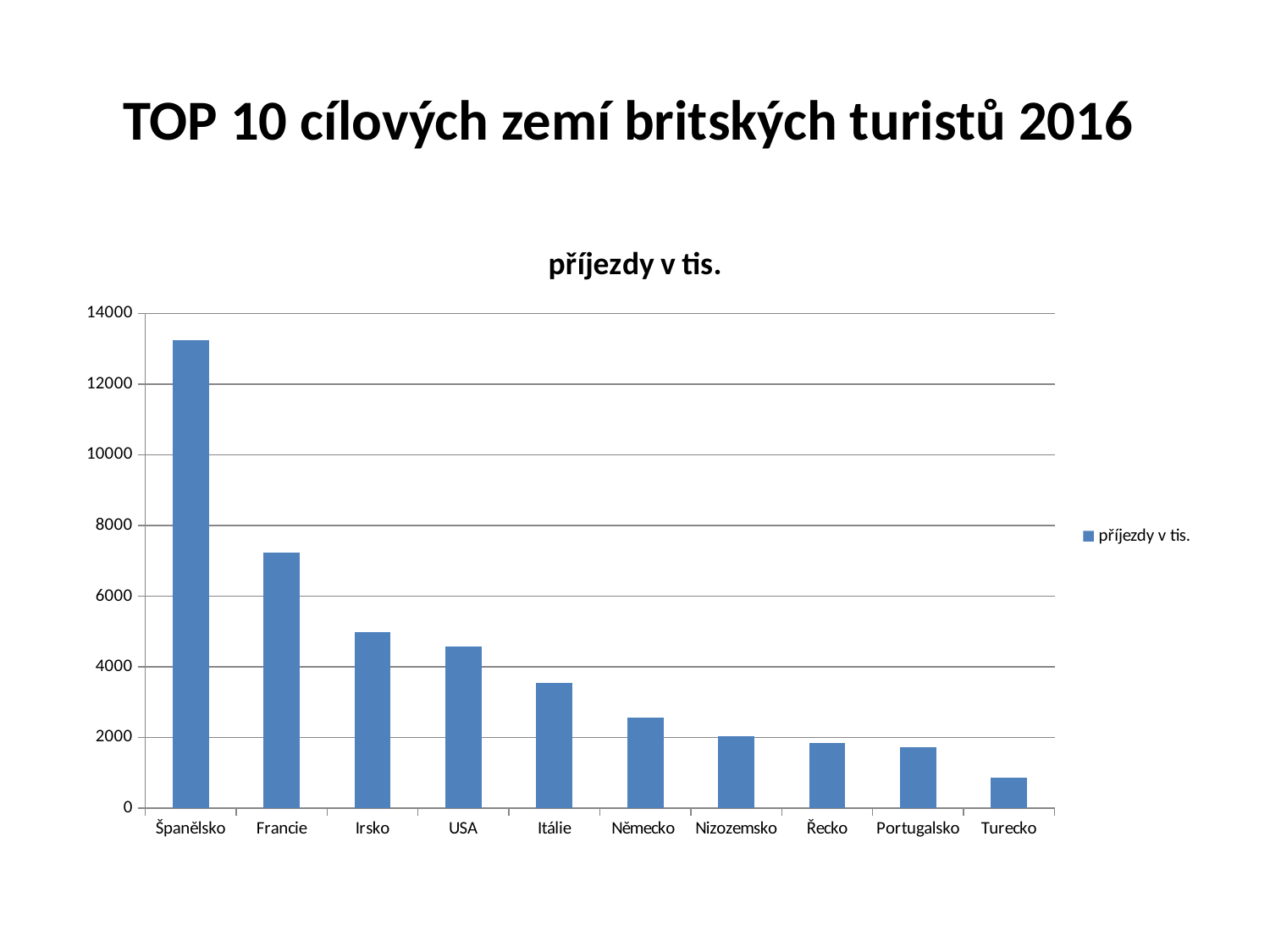
Is the value for Turecko greater or less than 2000? less How many countries are shown on the x axis of the chart? 10 How many series does the legend list? 1 What is the title of the chart? příjezdy v tis. What type of chart is shown on the slide? bar chart Is the value for USA greater or less than 4000? greater Which has a larger value, Francie or Irsko? Francie Is the value for Španělsko greater or less than 12000? greater Do the values rise or fall from left to right along the x axis? fall Which country has the lowest value in the chart? Turecko Which country has the highest value in the chart? Španělsko